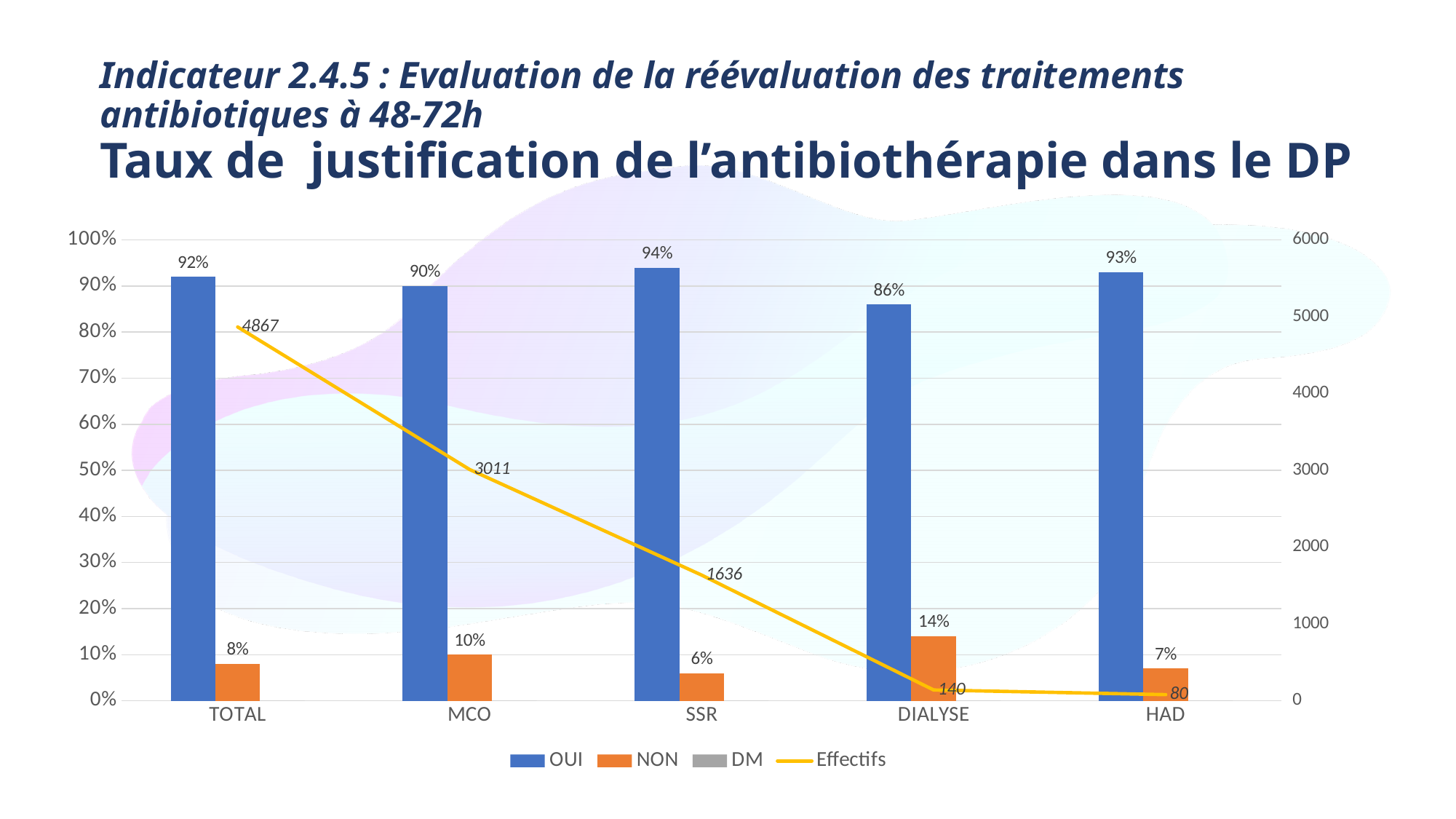
What is the difference between the OUI values for HAD and DIALYSE? 7% How many categories are shown on the x axis? 5 What is the NON value for DIALYSE? 14% Does the Effectifs line rise or fall from TOTAL to HAD? fall Which category has the highest OUI value? SSR Which is larger, the NON value for MCO or the NON value for TOTAL? MCO How many series does the legend list? 4 What is the Effectifs value for MCO? 3011 What is the OUI value for SSR? 94% Which category has the lowest NON value? SSR Which category has the lowest OUI value? DIALYSE What is the Effectifs value for HAD? 80